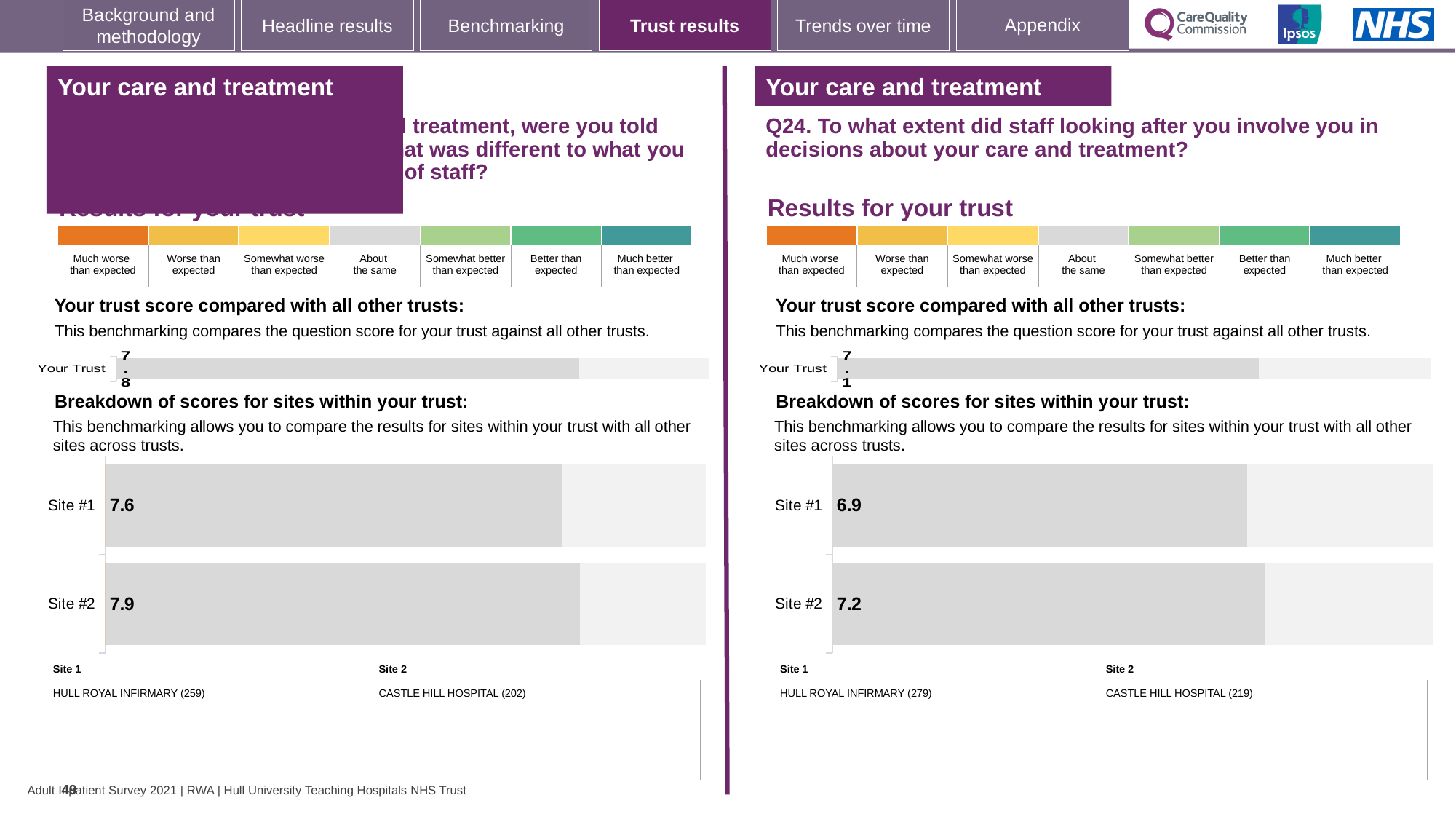
In the Q24 site breakdown chart on the right-hand side, what is the difference between the Site #2 and Site #1 scores? 0.3 In the Q24 site breakdown chart on the right-hand side of the slide, what is the score for Site #1? 6.9 How many sites are shown in the Q24 site breakdown chart on the right-hand side of the slide? 2 In the Q24 site breakdown chart on the right-hand side of the slide, what is the score for Site #2? 7.2 In the Q24 'Your trust score compared with all other trusts' chart on the right-hand side, what is the 'Your Trust' score? 7.1 In the Q24 site breakdown chart on the right-hand side, which site has the lower score? Site #1 On the left-hand side of the slide, which site has the higher score in the site breakdown chart? Site #2 On the left-hand side of the slide, in the 'Breakdown of scores for sites within your trust' chart, what is the score for Site #2? 7.9 On the left-hand side of the slide, what is the difference between the Site #2 and Site #1 scores in the site breakdown chart? 0.3 On the left-hand side of the slide, what is the 'Your Trust' score shown in the 'Your trust score compared with all other trusts' chart? 7.8 What type of chart is used for the site breakdown on the left-hand side of the slide? Bar chart On the left-hand side of the slide, in the 'Breakdown of scores for sites within your trust' chart, what is the score for Site #1? 7.6